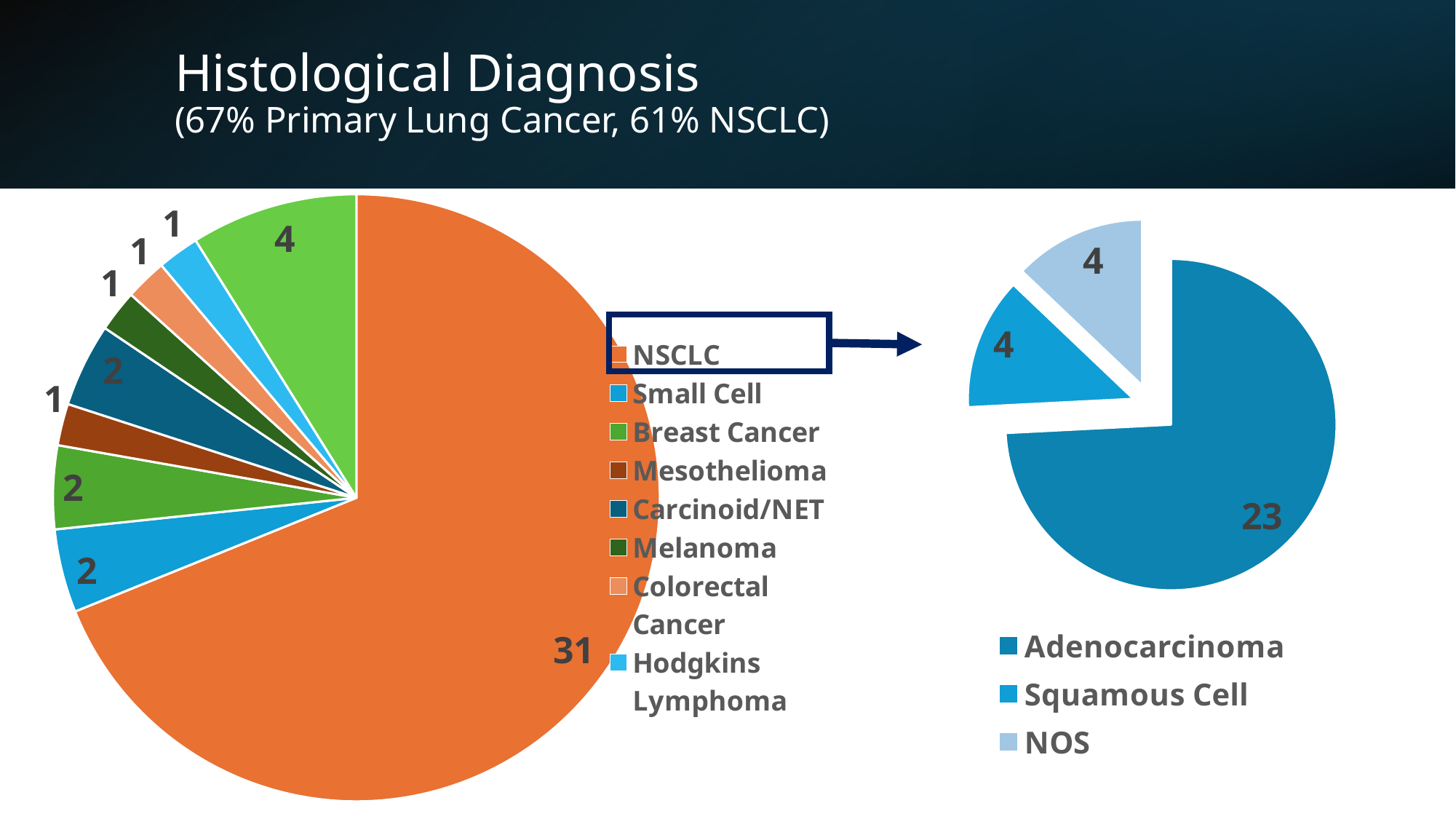
In the right pie chart, what is the total of all three slices? 31 In the right pie chart, what is the value for NOS? 4 In the left pie chart, how many entries does the legend list? 8 In the right pie chart, how many categories does the legend list? 3 In the left pie chart, what is the value for NSCLC? 31 What kind of chart is shown on the right side of the slide? Pie chart In the left pie chart, which category has the largest slice? NSCLC In the right pie chart, which category has the largest slice? Adenocarcinoma In the right pie chart, what is the value for Adenocarcinoma? 23 In the left pie chart, what is the value for Mesothelioma? 1 In the left pie chart, what is the difference between the NSCLC value and the Small Cell value? 29 In the left pie chart, what is the value for Small Cell? 2